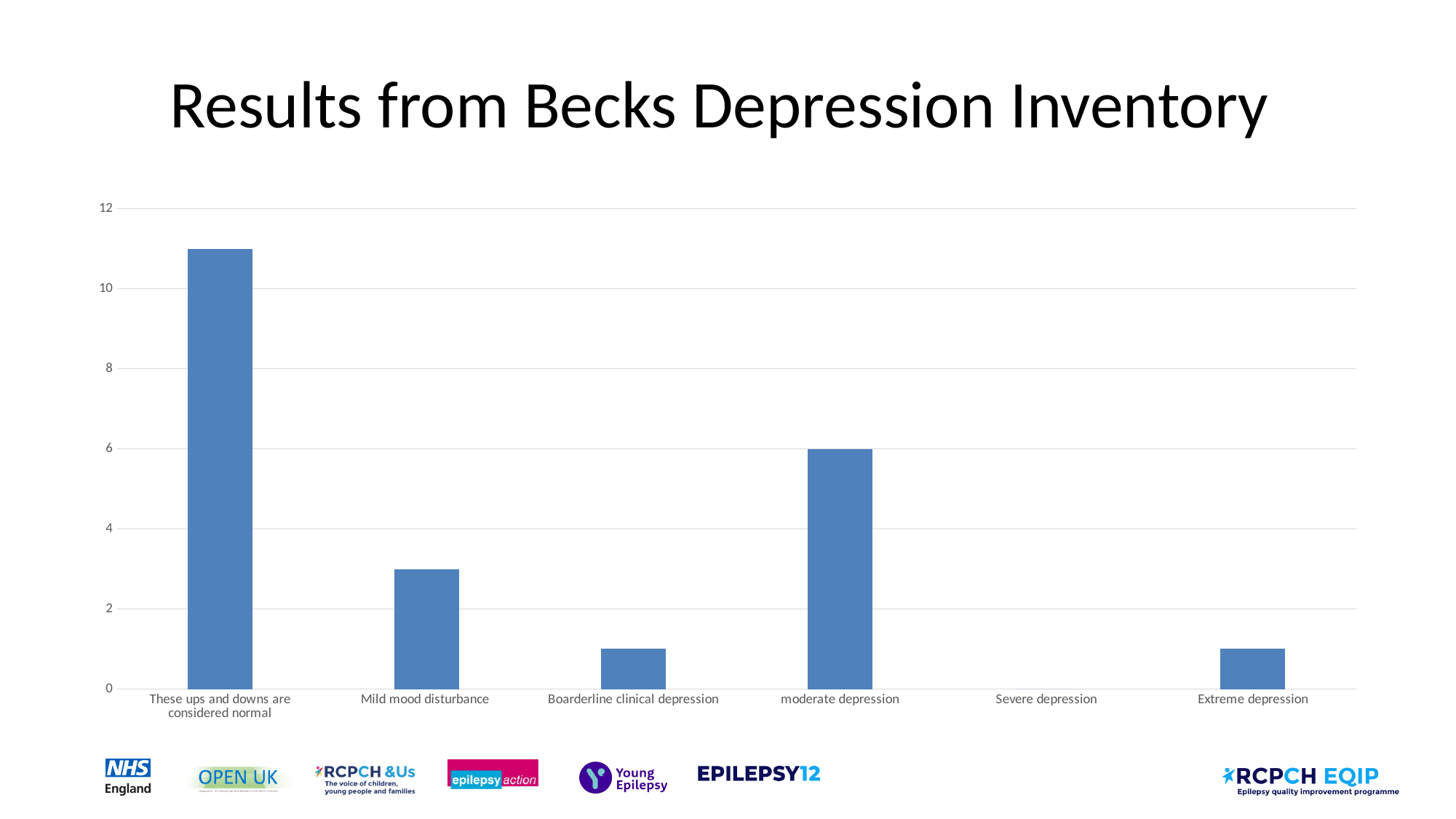
Is the value for Mild mood disturbance greater or less than 4? less Which is larger, the value for These ups and downs are considered normal or the value for Extreme depression? These ups and downs are considered normal Which category has the highest value? These ups and downs are considered normal What is the value for Severe depression? 0 What type of chart is shown on the slide? bar chart How many categories are shown on the x axis? 6 What is the title of the chart? Results from Becks Depression Inventory Is the value for Boarderline clinical depression greater or less than 2? less Is the value for These ups and downs are considered normal greater or less than 10? greater What is the value for moderate depression? 6 Which is larger, the value for Mild mood disturbance or the value for moderate depression? moderate depression Which category has the lowest value? Severe depression